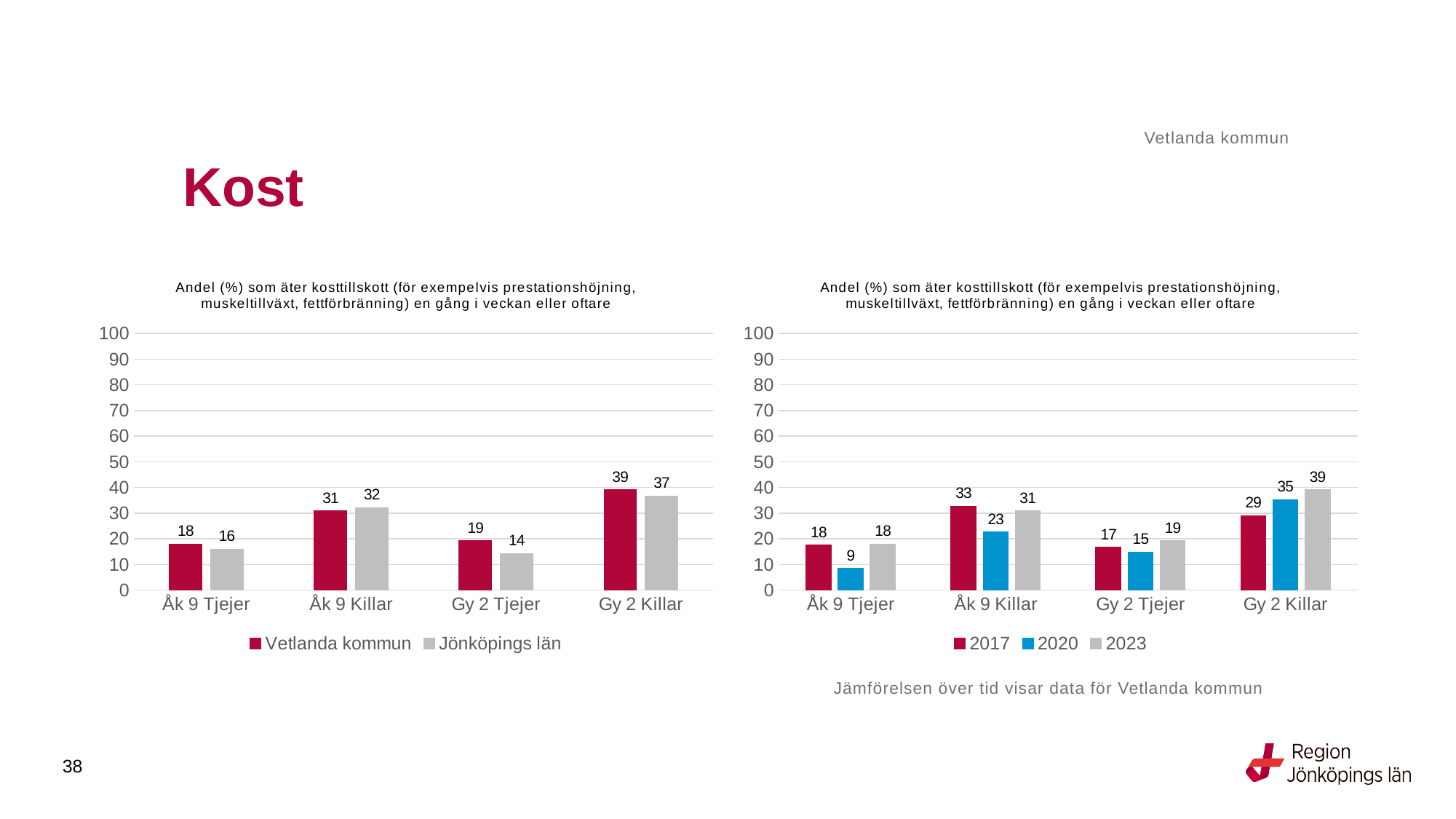
In the left chart, what is the value for Vetlanda kommun for Gy 2 Killar? 39 What kind of chart is the right chart? bar chart In the right chart, what is the difference between 2017 and 2020 for Åk 9 Killar? 10 How many series does the legend of the left chart list? 2 In the left chart, which category has the lowest value for Jönköpings län? Gy 2 Tjejer In the right chart, which category has the highest value for 2017? Åk 9 Killar In the right chart, what is the value for 2020 for Åk 9 Tjejer? 9 In the right chart, do the values for Gy 2 Killar rise or fall from 2017 to 2023? rise In the left chart, what is the value for Jönköpings län for Gy 2 Tjejer? 14 In the left chart, which is larger for Åk 9 Killar: Vetlanda kommun or Jönköpings län? Jönköpings län In the right chart, what is the value for 2023 for Gy 2 Killar? 39 In the left chart, what is the difference between Vetlanda kommun and Jönköpings län for Gy 2 Tjejer? 5